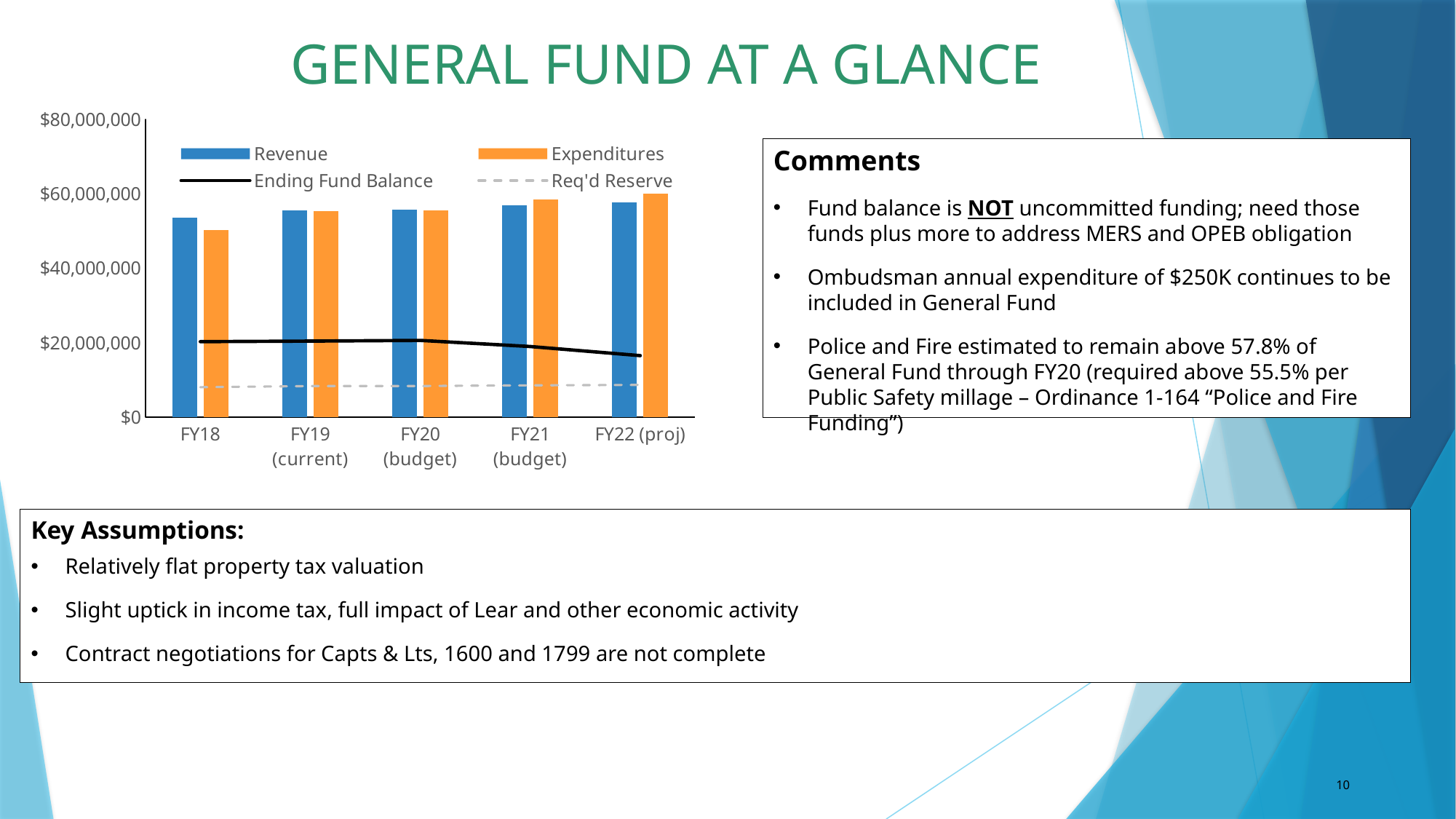
In FY22 (proj), which is larger, Revenue or Expenditures? Expenditures What colour are the Expenditures bars in the chart? orange In which fiscal year are Expenditures highest? FY22 (proj) How many series does the chart legend list? 4 Which series is drawn as a dashed grey line in the chart? Req'd Reserve In FY18, which is larger, Revenue or Expenditures? Revenue Does the Ending Fund Balance line rise or fall from FY20 (budget) to FY22 (proj)? fall What kind of chart is used for Revenue and Expenditures on the slide? bar chart In which fiscal year is Revenue lowest? FY18 In which fiscal year are Expenditures lowest? FY18 How many fiscal year categories are shown on the x axis of the chart? 5 Is the Expenditures value for FY18 greater or less than $60,000,000? less